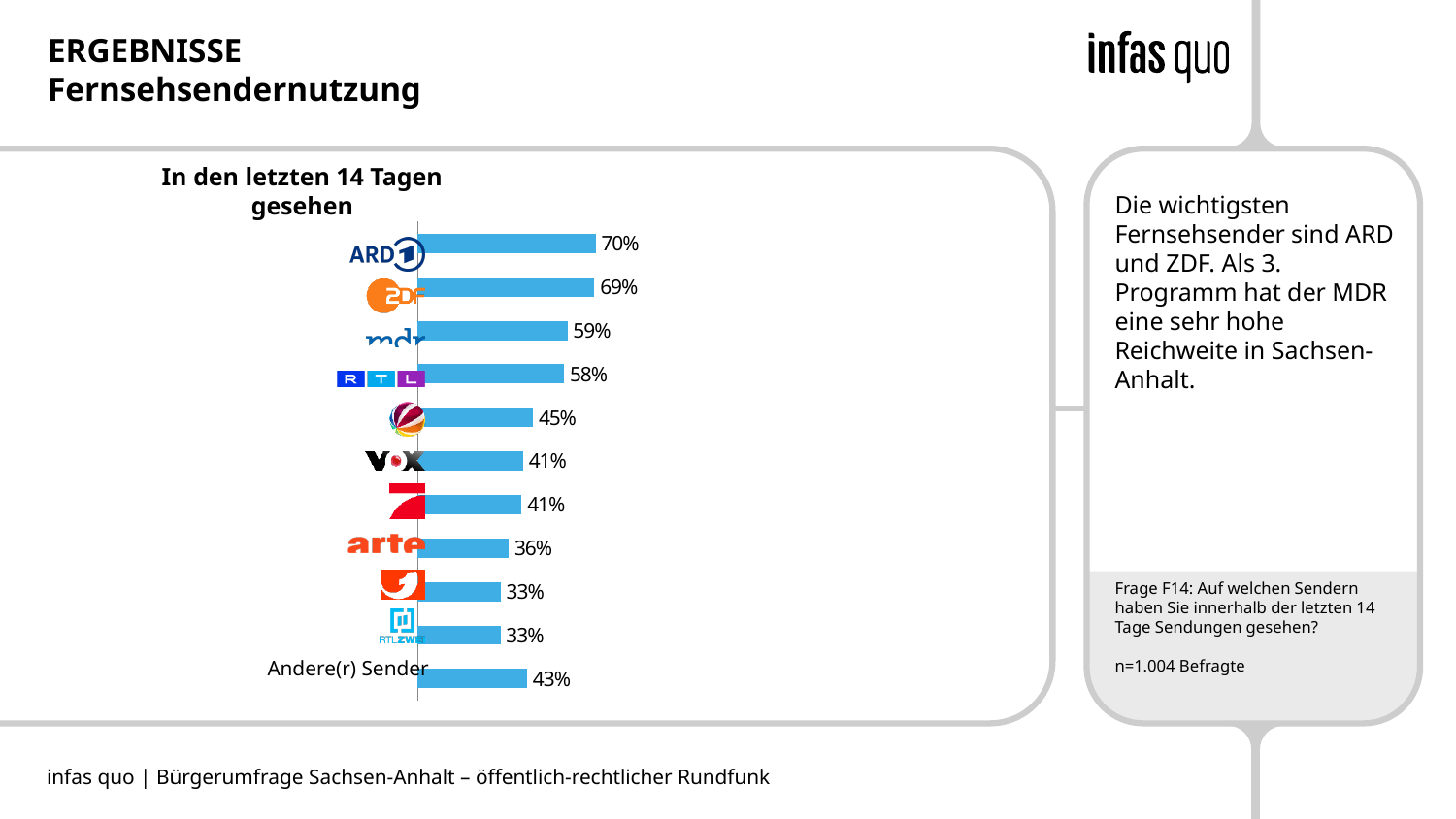
What is the title of the chart? In den letzten 14 Tagen gesehen What percentage is shown for RTL? 58% What percentage is shown for ARD? 70% Which channel has the highest value in the chart? ARD What percentage is shown for arte? 36% What percentage is shown for Andere(r) Sender? 43% What is the difference between the values for ARD and mdr? 11 percentage points Which has a larger value, RTL or VOX? RTL What percentage is shown for mdr? 59% How many bars are shown in the chart? 11 What percentage is shown for ZDF? 69% What type of chart is shown on the slide? Bar chart